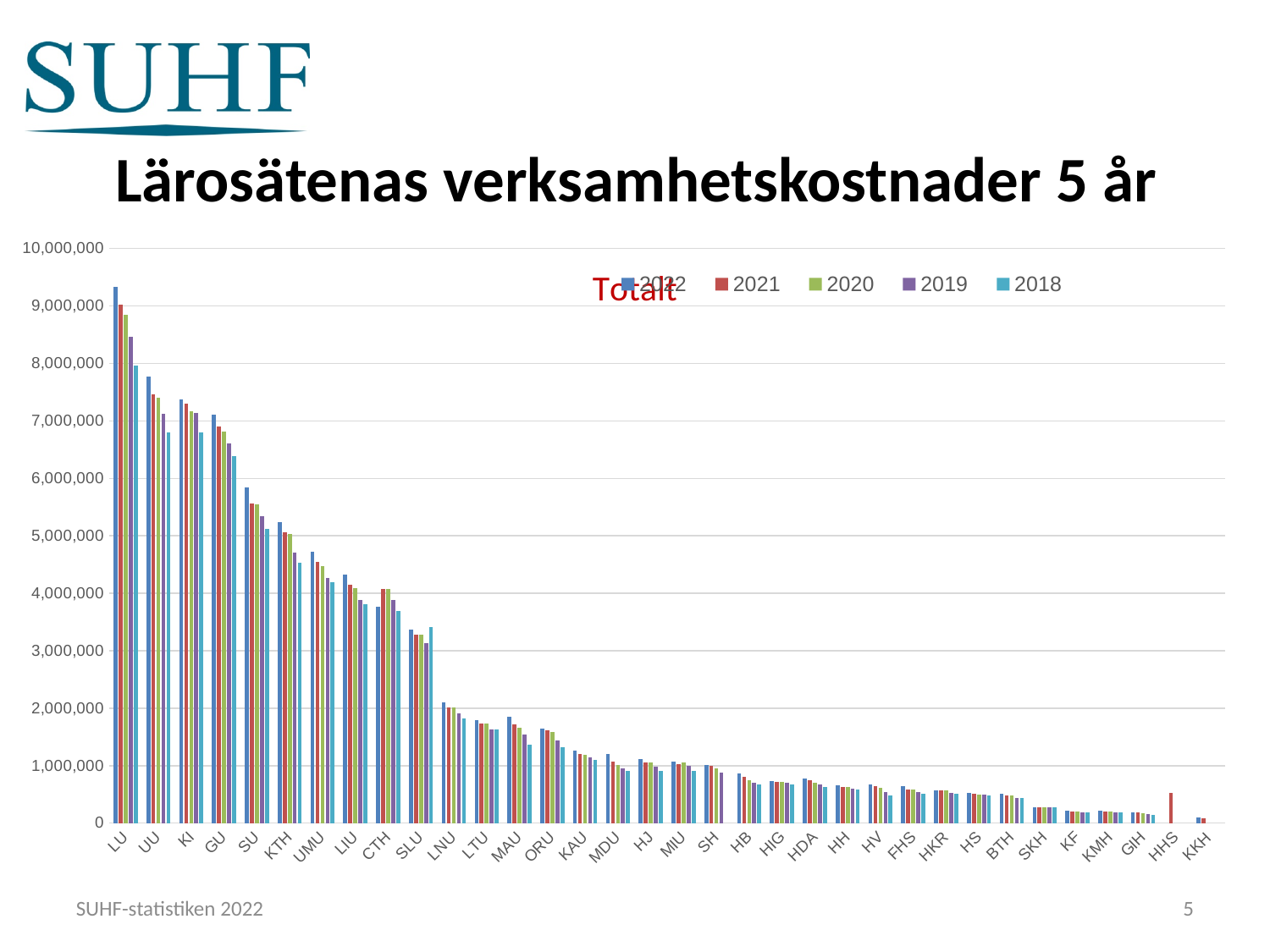
Which has the larger 2022 value, LU or UU? LU Which years are listed in the legend? 2022, 2021, 2020, 2019, 2018 Is the 2022 value for LU greater or less than 9,000,000? greater Which institution has the highest 2022 value? LU Which has the larger 2022 value, KI or GU? KI Is the 2022 value for KKH greater or less than 1,000,000? less What kind of chart is shown on the slide? bar chart Is the 2022 value for SU greater or less than 5,000,000? greater How many series does the legend list? 5 Do the 2022 values generally rise or fall moving from left to right along the x axis? fall What is the title of the chart? Lärosätenas verksamhetskostnader 5 år